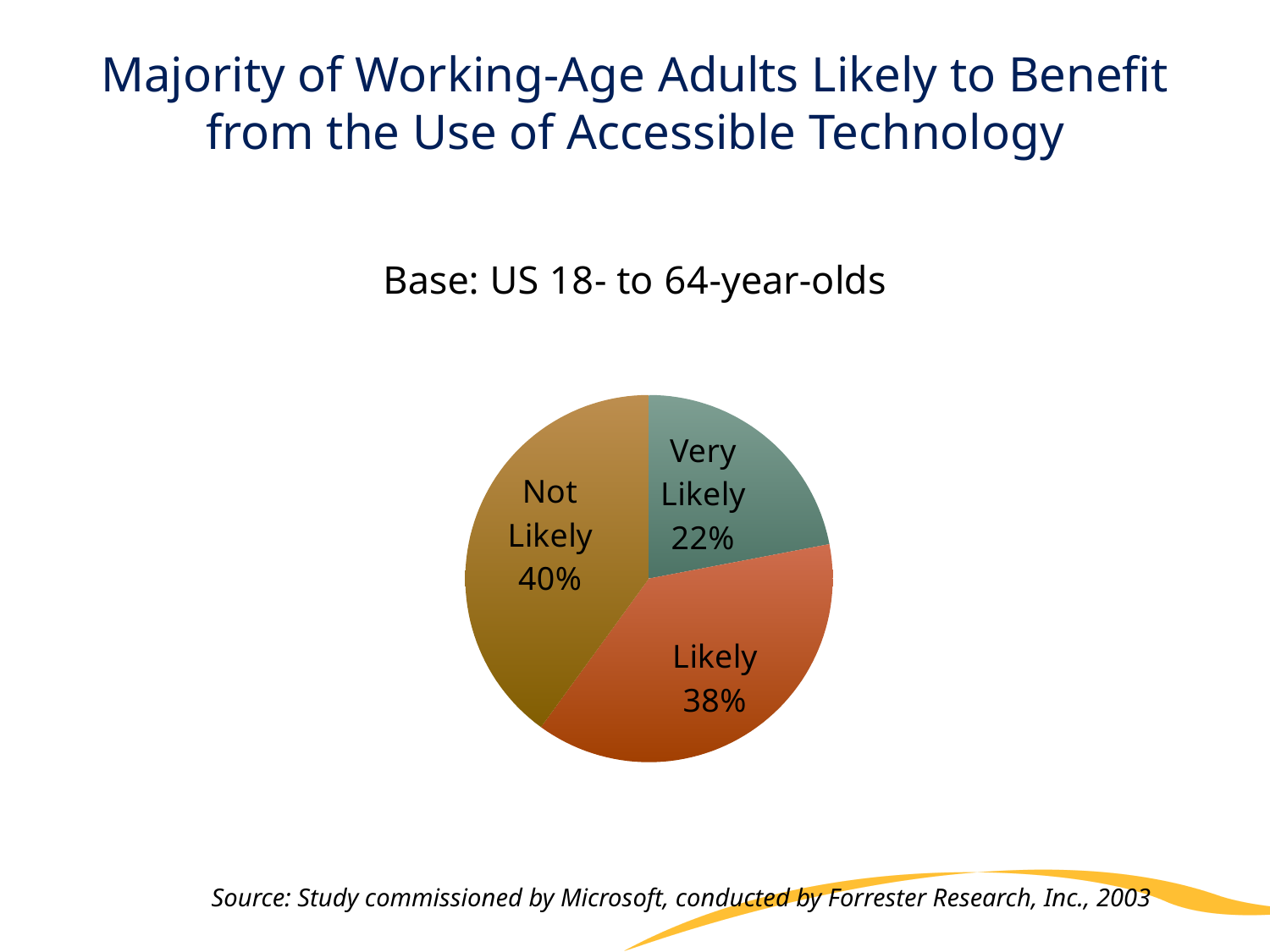
How many slices does the pie chart have? 3 What is the difference in percentage points between the "Likely" and "Very Likely" slices? 16 What base population is stated above the pie chart? US 18- to 64-year-olds What kind of chart is shown on the slide? Pie chart What percentage of the pie is labelled "Very Likely"? 22% Which is larger, the "Likely" slice or the "Very Likely" slice? Likely What is the difference in percentage points between the "Not Likely" and "Very Likely" slices? 18 What percentage of the pie is labelled "Not Likely"? 40% Which slice of the pie chart is the largest? Not Likely What percentage of the pie is labelled "Likely"? 38% Which slice of the pie chart is the smallest? Very Likely What is the combined percentage of the "Very Likely" and "Likely" slices? 60%